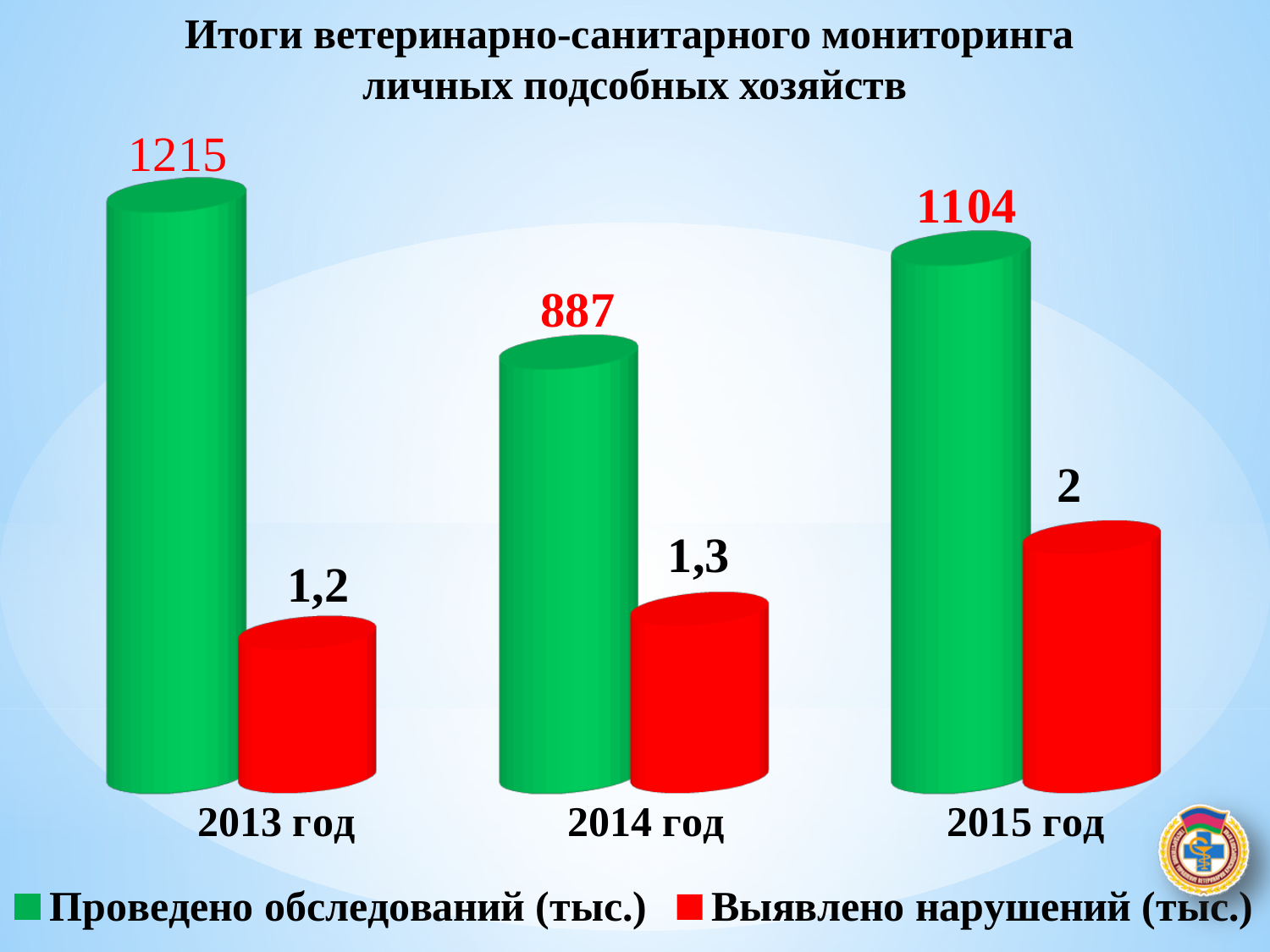
What kind of chart is shown on the slide? Bar chart What is the value of "Выявлено нарушений (тыс.)" for 2015 год? 2 In which year is "Проведено обследований (тыс.)" lowest? 2014 год What is the value of "Выявлено нарушений (тыс.)" for 2014 год? 1,3 What is the value of "Проведено обследований (тыс.)" for 2014 год? 887 In which year is "Выявлено нарушений (тыс.)" lowest? 2013 год How many series does the legend list? 2 Which is larger: "Проведено обследований (тыс.)" in 2014 год or in 2015 год? 2015 год What is the difference between "Проведено обследований (тыс.)" in 2013 год and 2015 год? 111 In which year is "Проведено обследований (тыс.)" highest? 2013 год What is the value of "Проведено обследований (тыс.)" for 2013 год? 1215 How many years are shown on the x axis? 3